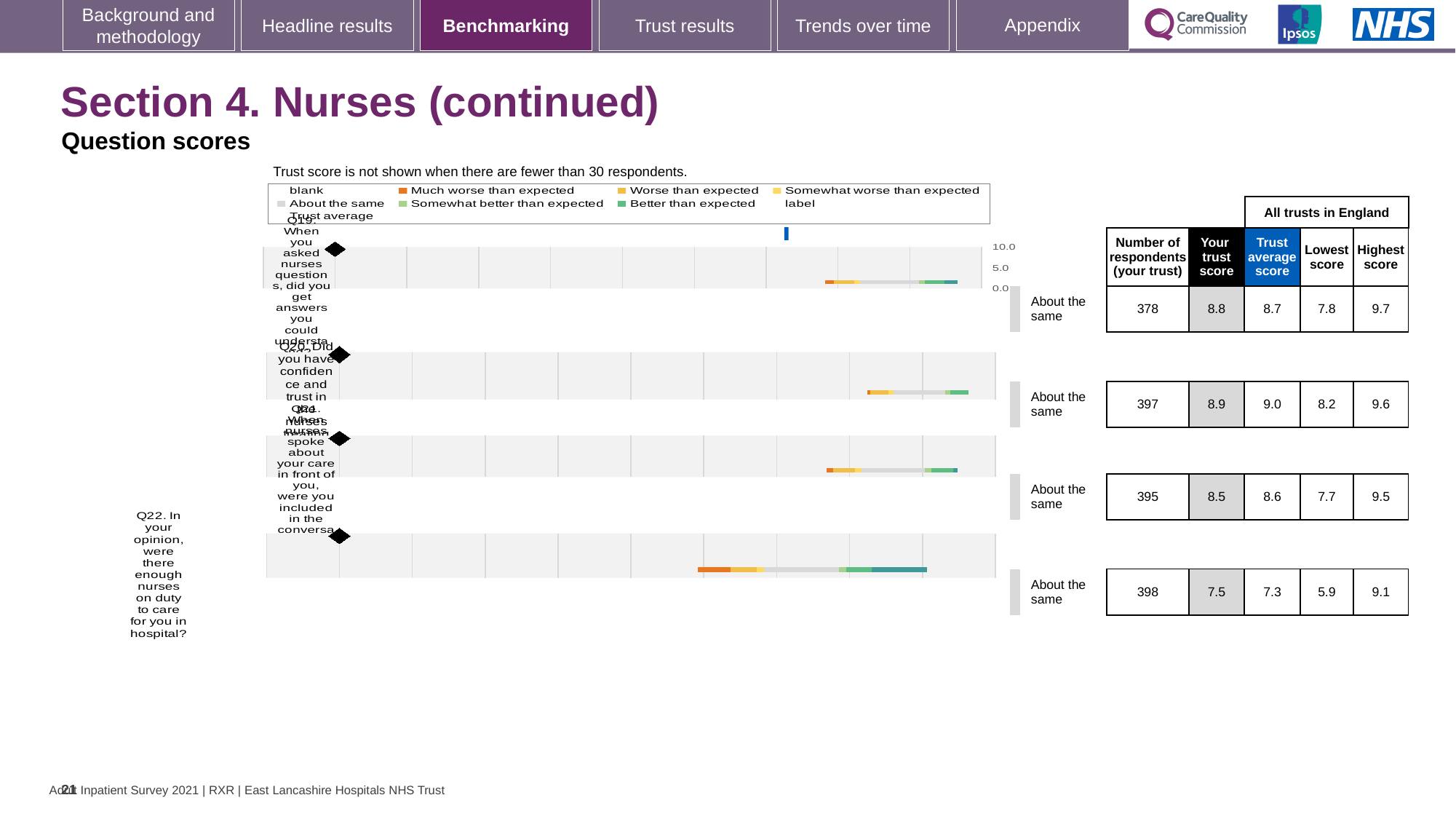
What benchmark category is shown next to each of the four questions? About the same What is the trust average score for Q20 (confidence and trust in nurses)? 9.0 What kind of chart is used to show the question scores? Bar chart Which question has the highest 'Your trust score'? Q20 For Q21, which is larger: your trust score or the trust average score? Trust average score What is your trust score for Q19 (getting answers you could understand from nurses)? 8.8 For Q22, what is the difference between your trust score and the trust average score? 0.2 What is the lowest score across all trusts in England for Q22? 5.9 What is the highest score across all trusts in England for Q19? 9.7 Which question has the lowest 'Your trust score'? Q22 How many questions are plotted on the chart? 4 How many respondents from your trust answered Q22 about whether there were enough nurses on duty? 398